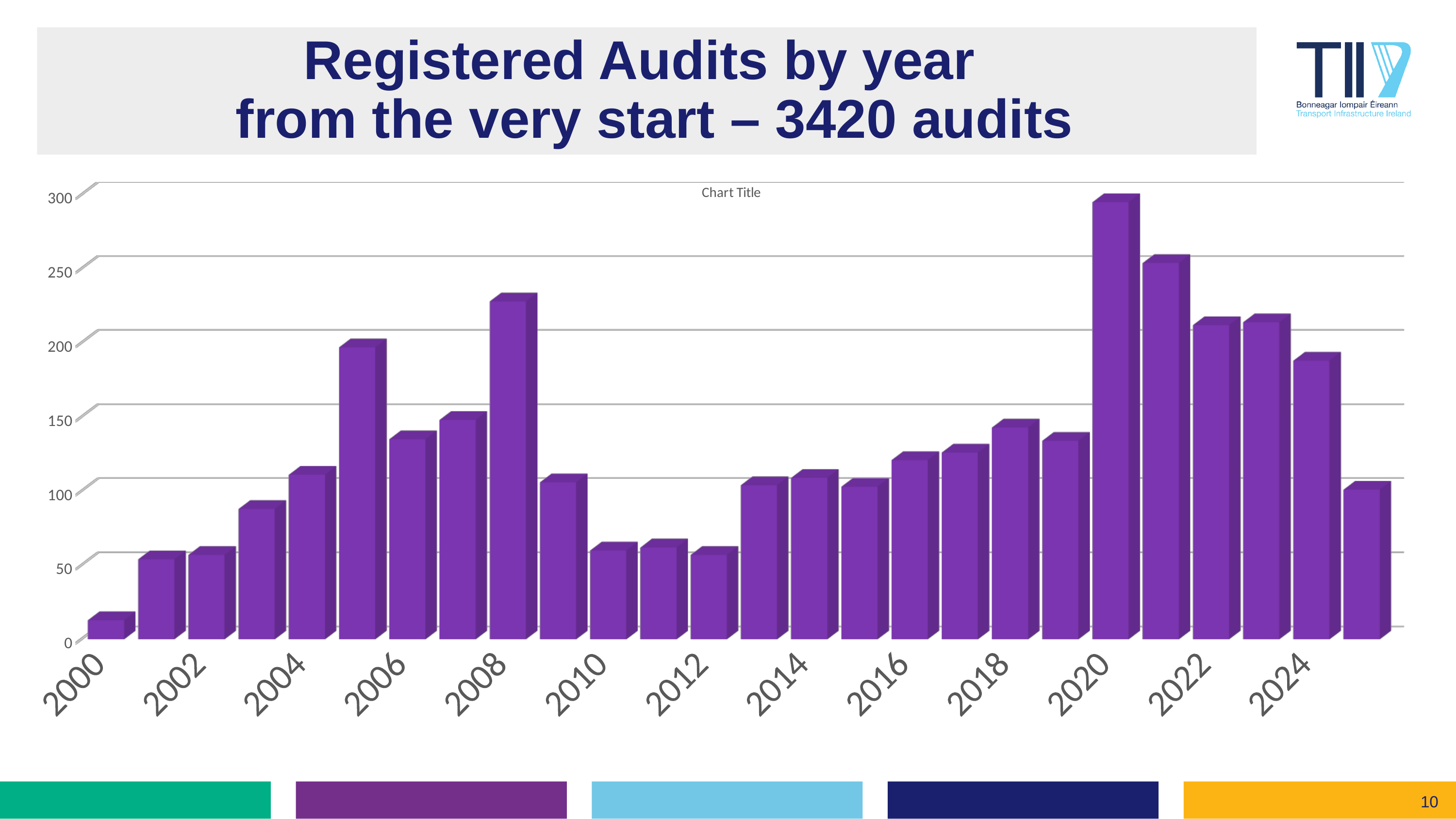
According to the slide title, how many audits have been registered in total from the very start? 3420 Which year has more registered audits, 2004 or 2010? 2004 How many bars (years) are plotted in the chart? 26 What kind of chart is shown on the slide? bar chart Is the value for 2024 greater or less than 200? less Which year has the lowest number of registered audits? 2000 Which year has more registered audits, 2008 or 2005? 2008 Is the value for 2008 greater or less than 200? greater Is the value for 2016 greater or less than 100? greater Which year has the highest number of registered audits? 2020